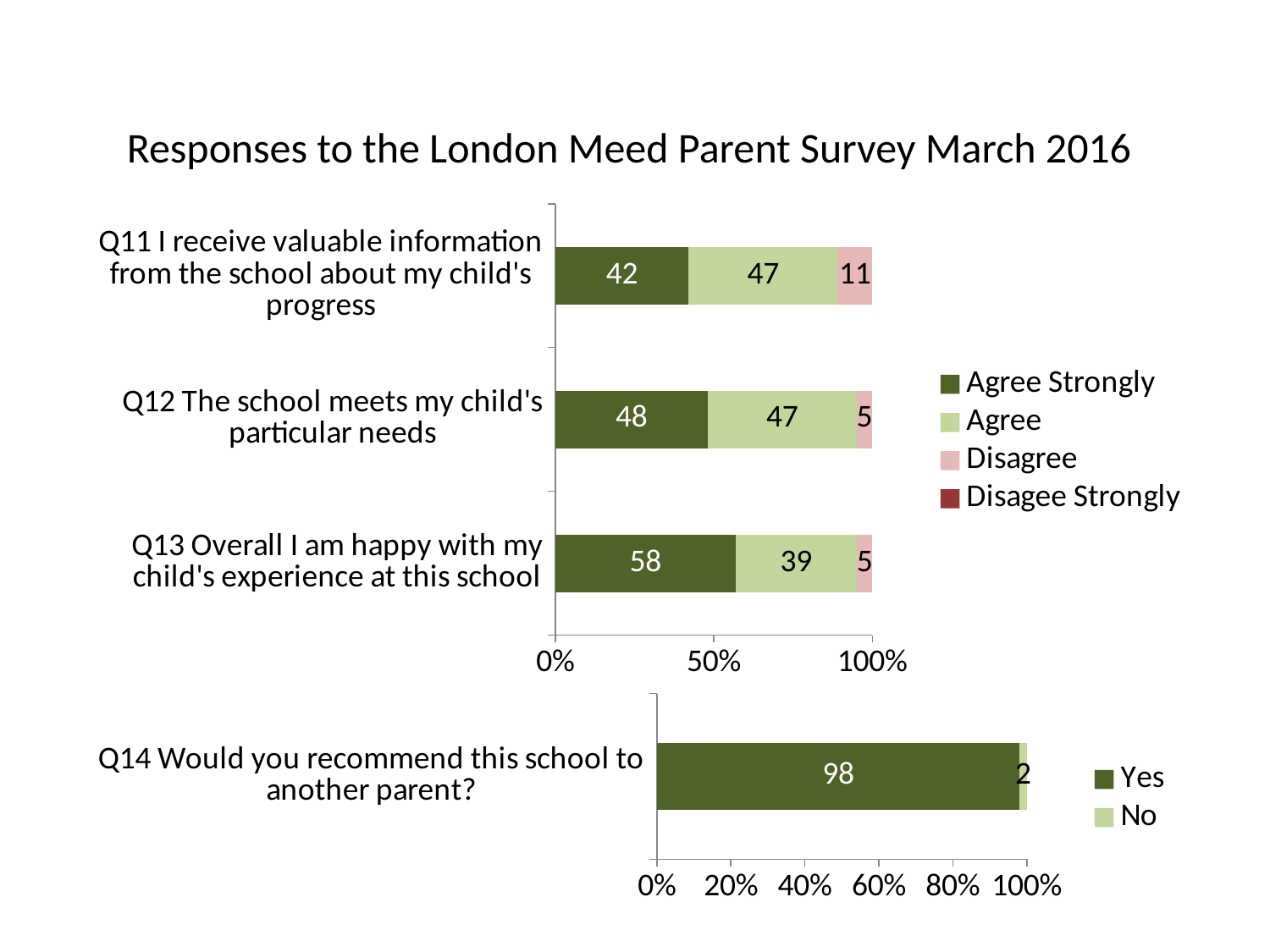
How many questions (categories) are plotted in the top chart? 3 In the top chart, which question has the highest Agree Strongly value? Q13 Overall I am happy with my child's experience at this school In the top chart, what is the Agree Strongly value for Q13 Overall I am happy with my child's experience at this school? 58 How many series does the legend of the top chart list? 4 In the top chart, which question has the lowest Agree value? Q13 Overall I am happy with my child's experience at this school What are the two legend entries of the bottom chart? Yes and No In the top chart, what is the difference between the Agree Strongly values for Q13 and Q11? 16 In the top chart, what is the total of the labelled segments for Q11 I receive valuable information from the school about my child's progress? 100 What kind of chart is the bottom chart showing Q14? Bar chart In the bottom chart, what is the Yes value for Q14 Would you recommend this school to another parent? 98 In the top chart, which has the larger Agree Strongly value, Q11 or Q12? Q12 The school meets my child's particular needs In the top chart, what is the Disagree value for Q11 I receive valuable information from the school about my child's progress? 11